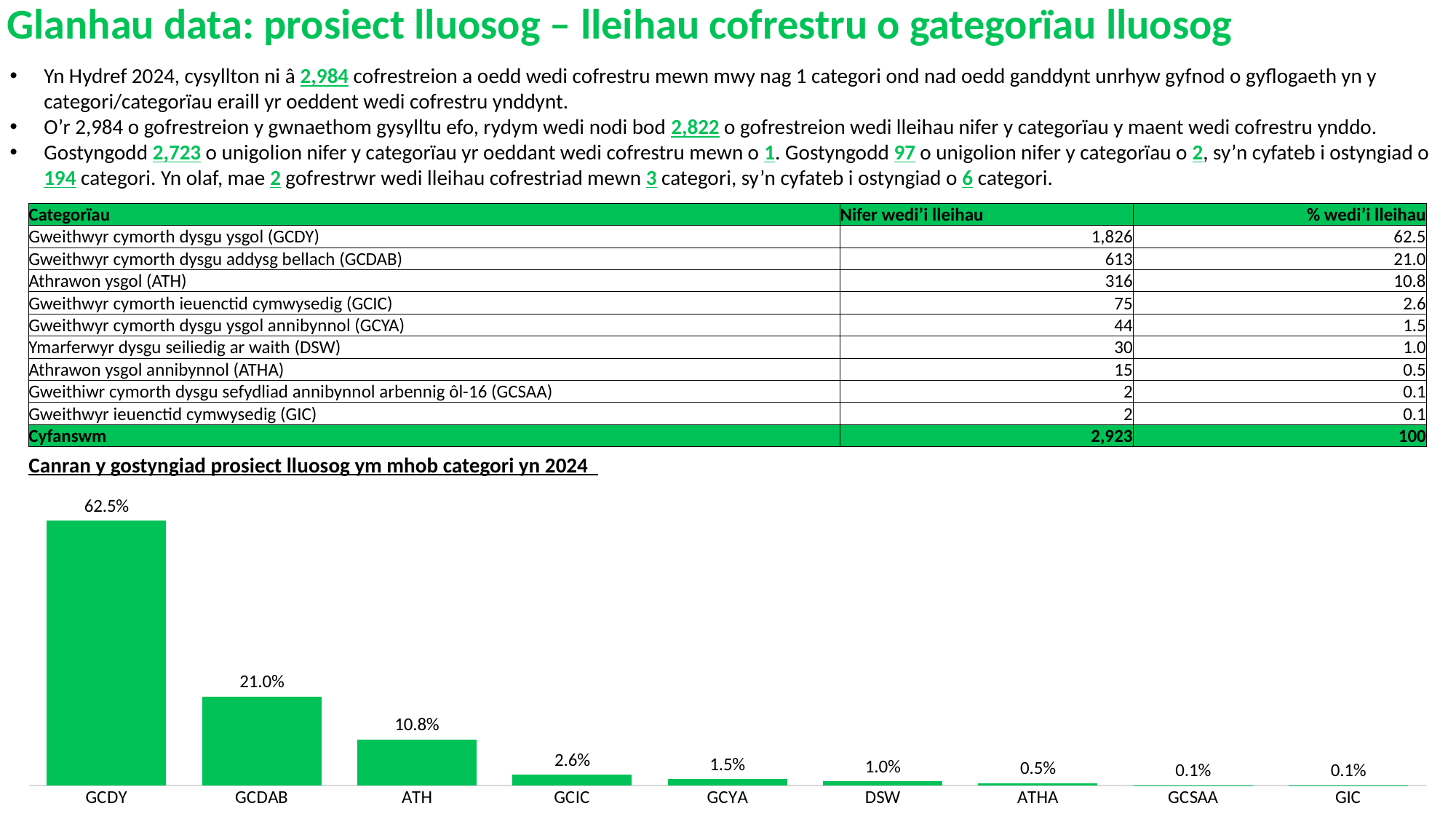
What is the difference between the values for ATH and GCIC? 8.2% Which is larger, the value for GCDAB or the value for ATH? GCDAB What is the value for ATH in the chart? 10.8% Which category has the highest value in the chart? GCDY What is the title of the chart? Canran y gostyngiad prosiect lluosog ym mhob categori yn 2024 What is the value for GCYA in the chart? 1.5% How many categories are shown on the x axis of the chart? 9 Do the values rise or fall from left to right along the x axis? Fall Which is larger, the value for DSW or the value for ATHA? DSW What is the value for GCDY in the chart? 62.5% What kind of chart is shown on the slide? Bar chart What is the difference between the values for GCDY and GCDAB? 41.5%